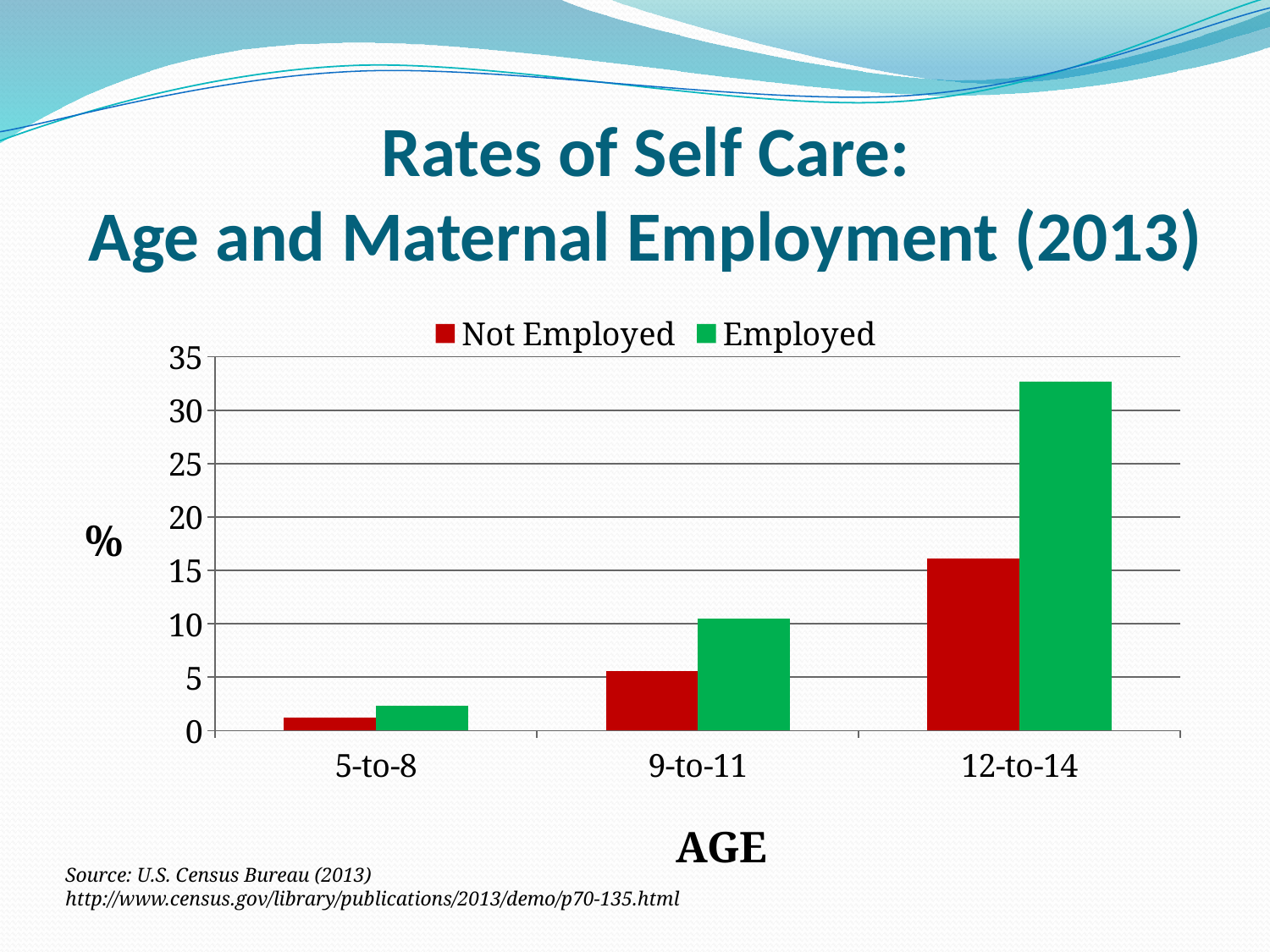
Do the Employed values rise or fall as age increases along the x axis? rise Which age group has the lowest Not Employed value? 5-to-8 Is the Employed value for 12-to-14 greater or less than 30? greater For the 12-to-14 age group, which is larger: Employed or Not Employed? Employed Is the Employed value for 5-to-8 greater or less than 5? less Which age group has the highest Employed value? 12-to-14 How many series does the legend list? 2 What kind of chart is shown on the slide? bar chart Is the Employed value for 9-to-11 greater or less than 15? less Which colour represents the Not Employed series in the legend? red How many age groups are shown on the x axis? 3